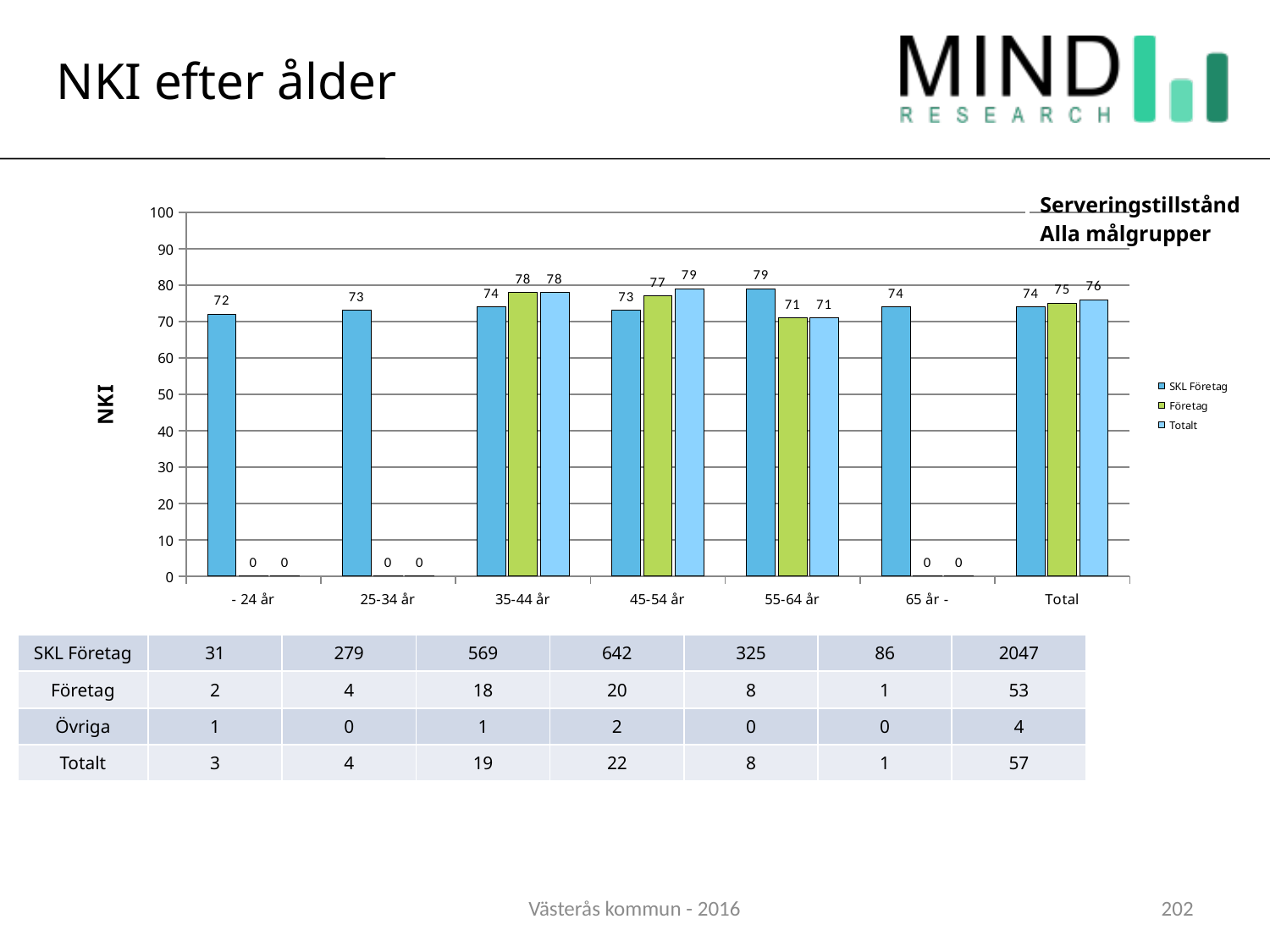
What kind of chart is shown on the slide? Bar chart Among the categories with non-zero Totalt values, which has the lowest Totalt value? 55-64 år What is the difference between the Totalt value and the Företag value for the 45-54 år category? 2 How many categories are shown on the x axis? 7 How many series does the legend list? 3 What is the Företag value for the 35-44 år category? 78 What is the SKL Företag value for the 55-64 år category? 79 What is the label on the y axis of the chart? NKI For the 55-64 år category, which is larger: the SKL Företag value or the Företag value? SKL Företag Which age category has the highest SKL Företag value? 55-64 år What is the Totalt value for the Total category? 76 Is the SKL Företag value for the - 24 år category greater or less than 70? greater